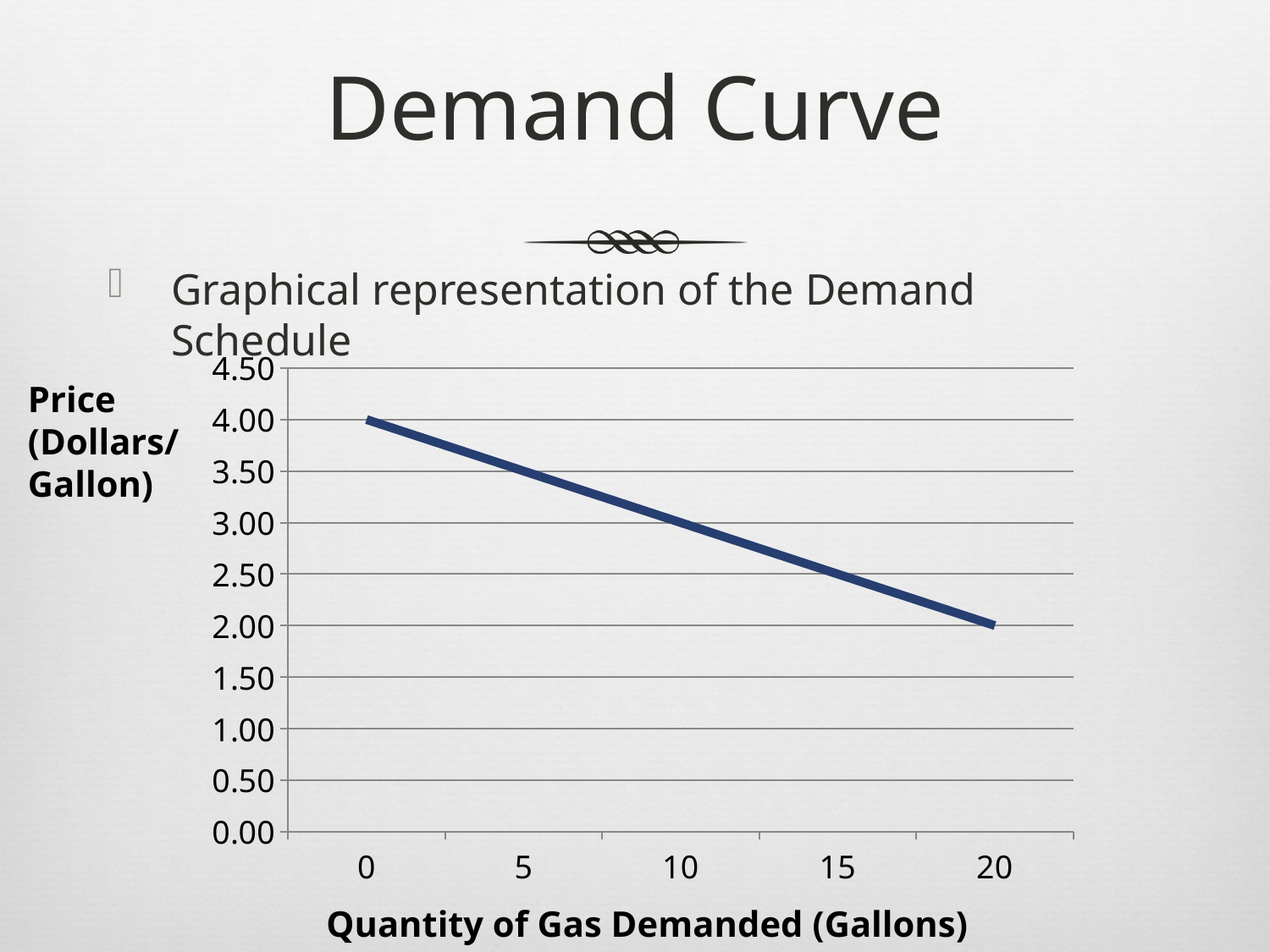
Does the price rise or fall as the quantity of gas demanded increases along the x axis? fall What is the label on the x axis of the chart? Quantity of Gas Demanded (Gallons) What is the price when the quantity of gas demanded is 20 gallons? 2.00 What kind of chart is shown on the slide? line chart What is the label on the y axis of the chart? Price (Dollars/Gallon) Is the price at a quantity of 5 gallons greater or less than 3.00? greater What is the price when the quantity of gas demanded is 0 gallons? 4.00 Is the price at a quantity of 15 gallons greater or less than 3.00? less Which quantity has the higher price, 0 gallons or 20 gallons? 0 gallons At which quantity of gas demanded is the price lowest? 20 At which quantity of gas demanded is the price highest? 0 What is the price when the quantity of gas demanded is 10 gallons? 3.00